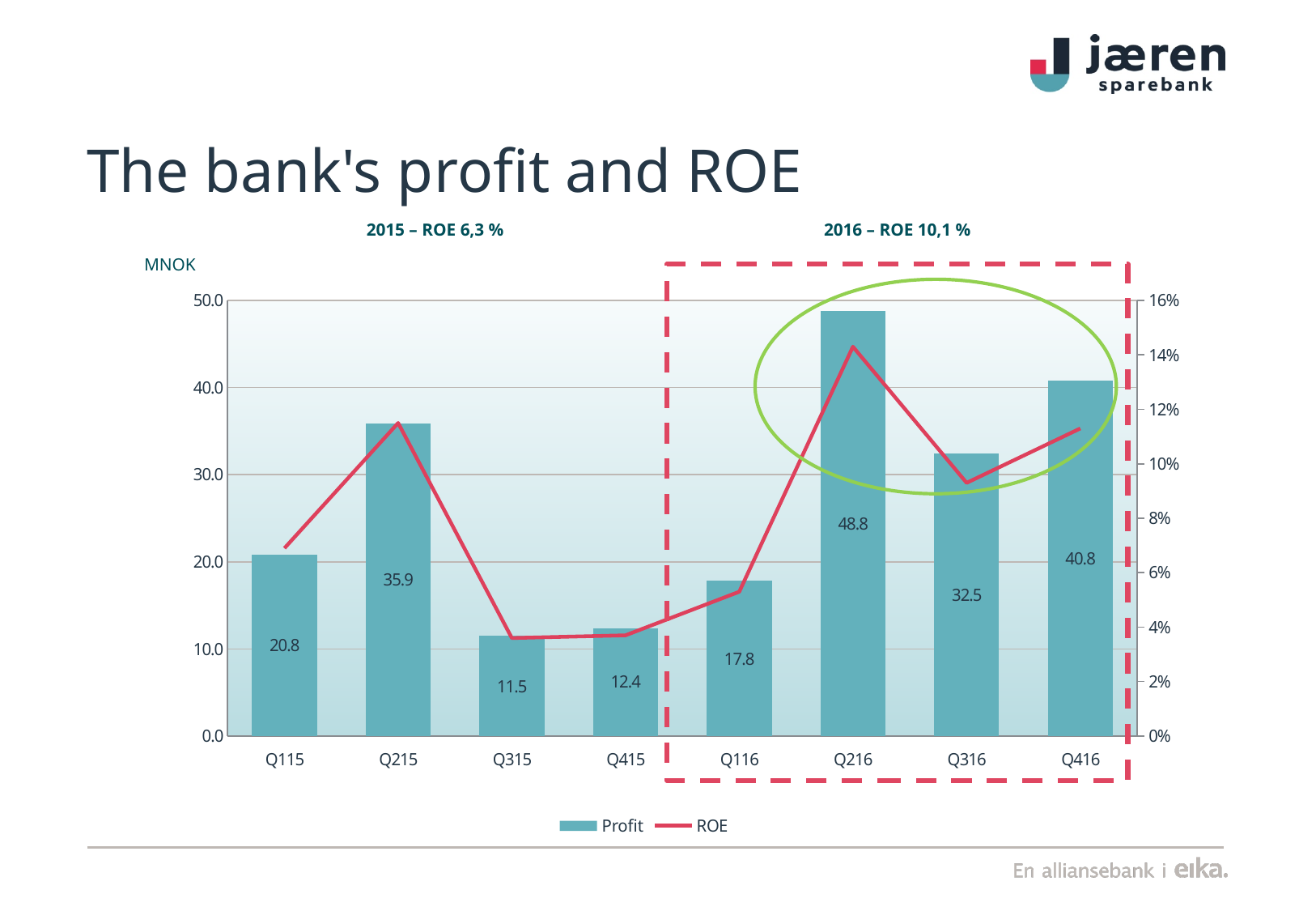
Does the profit rise or fall from Q116 to Q216? rise Which quarter has the highest profit? Q216 What is the profit for Q216? 48.8 Is the ROE for Q216 greater or less than 12%? greater What annual ROE is stated for 2016 above the chart? 10,1 % What is the difference in profit between Q216 and Q116? 31.0 Which quarter has the lowest profit? Q315 Is the ROE for Q315 greater or less than 8%? less How many quarters are shown on the x axis? 8 Which quarter has the larger profit, Q215 or Q416? Q416 How many series does the legend list? 2 What is the profit for Q315? 11.5